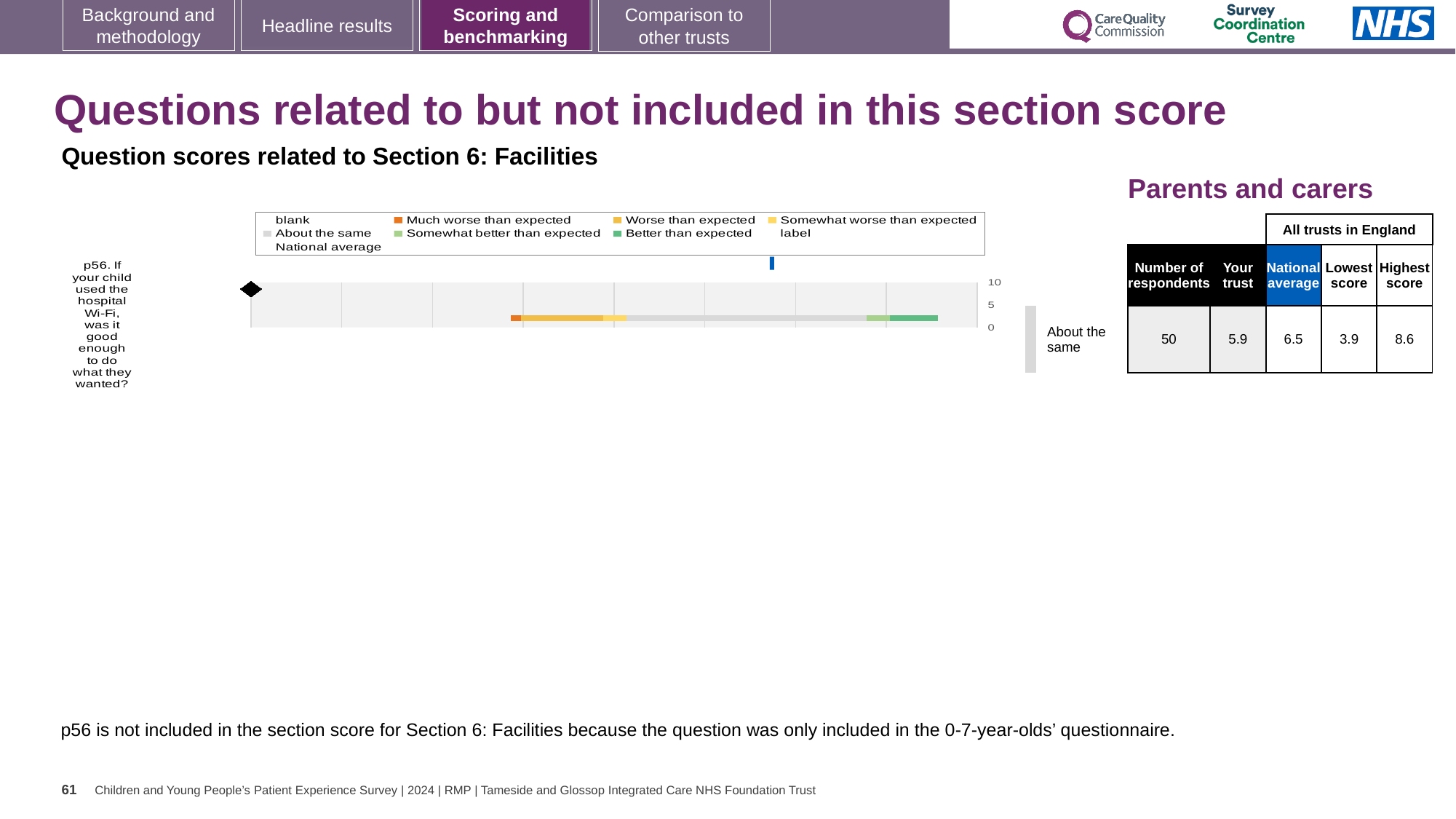
How many questions are plotted in the chart? 1 What is the highest value shown on the chart's axis? 10 In the table next to the chart, what is the difference between the highest score and the lowest score for p56? 4.7 What benchmark category label is shown to the right of the p56 bar? About the same What colour does the legend use for 'Better than expected'? green In the table next to the chart, which is larger for p56: the 'Your trust' score or the National average? National average In the table next to the chart, what is the lowest score among all trusts in England for p56? 3.9 In the table next to the chart, how many respondents answered p56? 50 Which question number is plotted in the chart? p56 In the table next to the chart, what is the 'Your trust' score for p56? 5.9 In the table next to the chart, what is the National average score for p56? 6.5 What kind of chart is used to show the p56 question score? bar chart